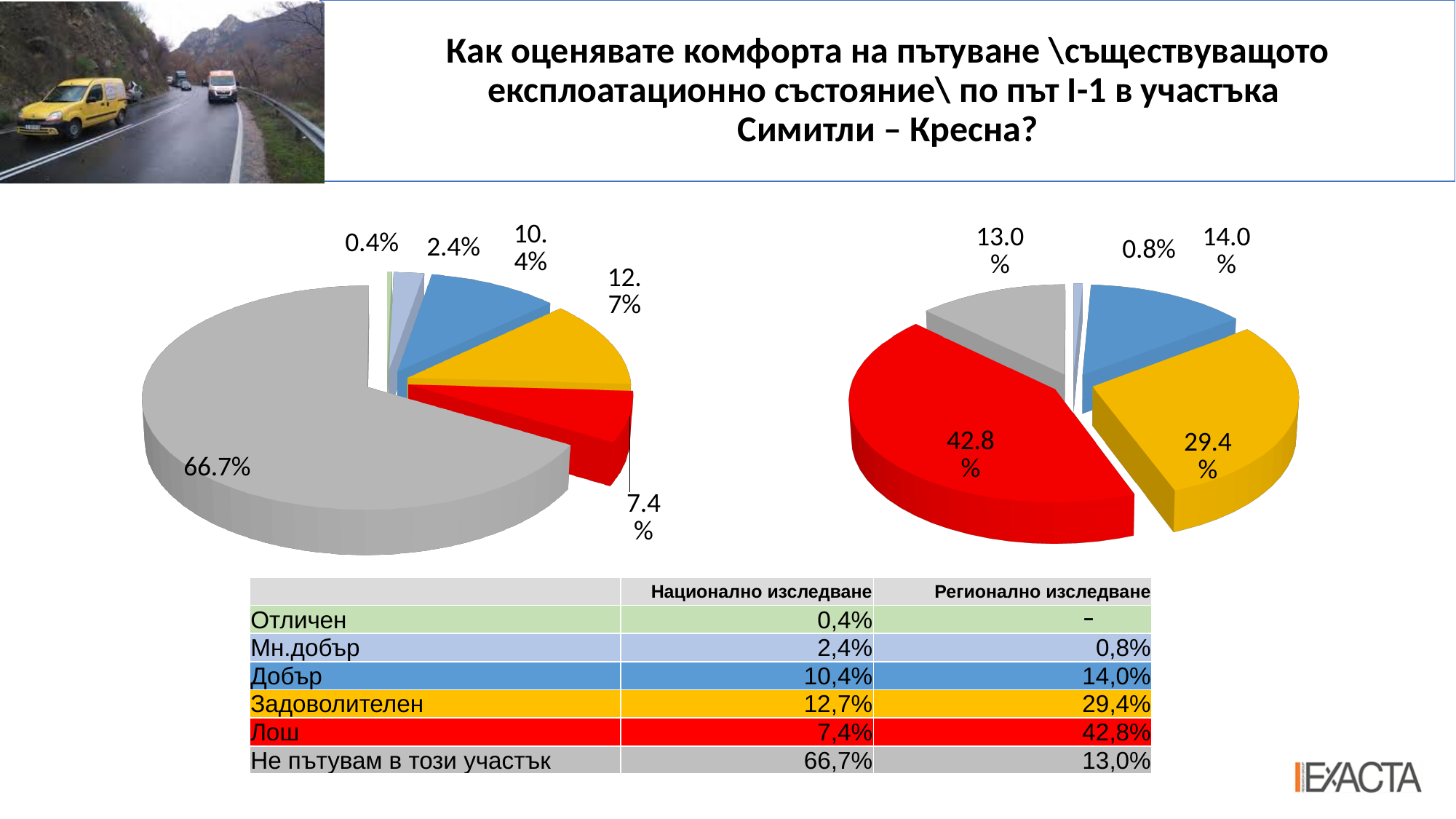
In the left pie chart (Национално изследване), what share does the red slice (Лош) have? 7.4% What kind of charts are shown on the slide? Pie charts In the right pie chart (Регионално изследване), what is the value of the largest slice? 42.8% In the right pie chart (Регионално изследване), what is the value of the smallest slice? 0.8% In the right pie chart (Регионално изследване), what is the difference between the red slice (42.8%) and the grey slice (13.0%)? 29.8% In the right pie chart (Регионално изследване), what share does the yellow slice (Задоволителен) have? 29.4% How many slices does the right pie chart (Регионално изследване) have? 5 In the right pie chart (Регионално изследване), which is larger: the red slice or the yellow slice? The red slice (42.8%) How many slices does the left pie chart (Национално изследване) have? 6 In the left pie chart (Национално изследване), what is the value of the smallest slice? 0.4% In the left pie chart (Национално изследване), what is the value of the largest slice? 66.7% In the left pie chart (Национално изследване), what is the difference between the yellow slice (12.7%) and the blue slice (10.4%)? 2.3%